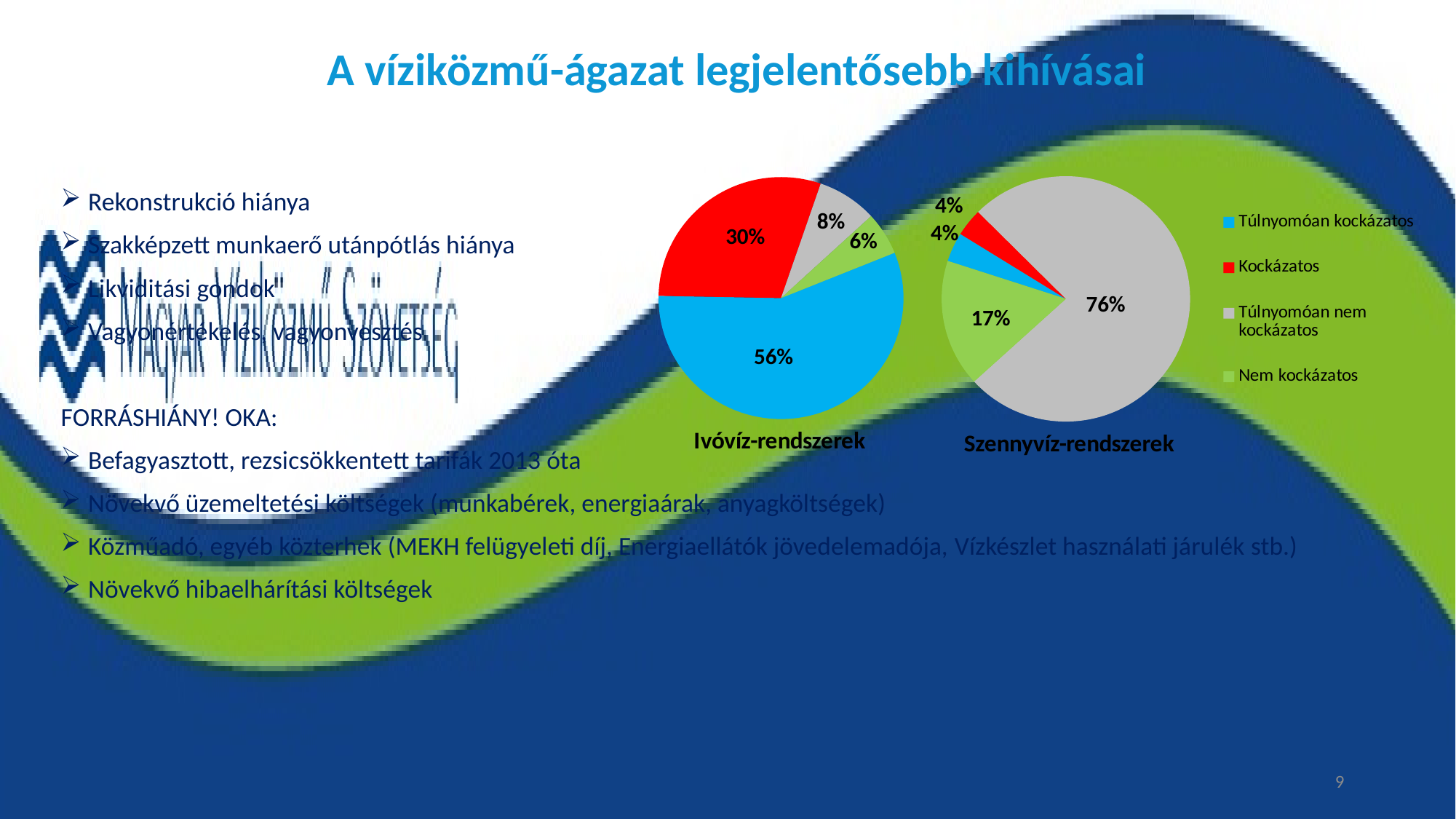
In the Ivóvíz-rendszerek chart, what share is labelled Nem kockázatos? 6% In the Ivóvíz-rendszerek chart, which category has the smallest slice? Nem kockázatos In the Ivóvíz-rendszerek chart, what share is labelled Kockázatos? 30% How many categories does the legend list for the pie charts? 4 In the Ivóvíz-rendszerek chart, which category has the largest slice? Túlnyomóan kockázatos In the Szennyvíz-rendszerek chart, which category has the largest slice? Túlnyomóan nem kockázatos In the Ivóvíz-rendszerek chart, what share is labelled Túlnyomóan kockázatos? 56% In the Szennyvíz-rendszerek chart, what share is labelled Túlnyomóan nem kockázatos? 76% In the Ivóvíz-rendszerek chart, what is the difference between the Túlnyomóan kockázatos and Kockázatos shares? 26% What kind of chart is the Ivóvíz-rendszerek chart? pie chart In the Szennyvíz-rendszerek chart, what share is labelled Nem kockázatos? 17% Which is larger in the Szennyvíz-rendszerek chart: Túlnyomóan nem kockázatos or Nem kockázatos? Túlnyomóan nem kockázatos